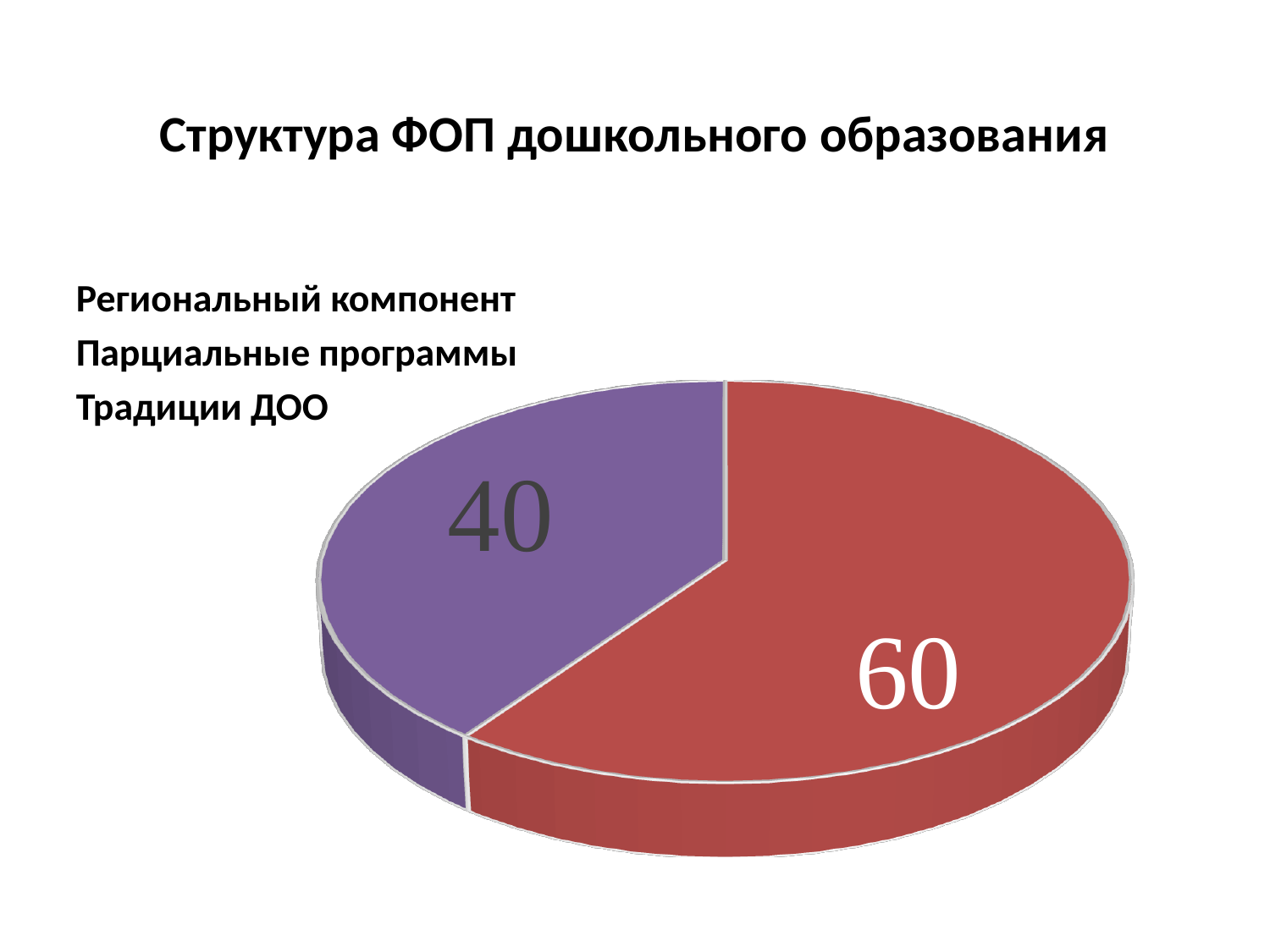
What value is printed on the red slice of the pie chart? 60 What share of the pie does the purple slice represent? 40% How many slices does the pie chart have? 2 What colour is the slice labelled 60? red Which slice of the pie chart has the largest value? the red slice (60) What is the title of the slide containing the pie chart? Структура ФОП дошкольного образования What is the difference between the values of the red slice and the purple slice? 20 What kind of chart is shown on the slide? pie chart What is the total of the two values printed on the pie chart? 100 Which slice of the pie chart has the smallest value? the purple slice (40) Which is larger, the red slice or the purple slice? the red slice What value is printed on the purple slice of the pie chart? 40